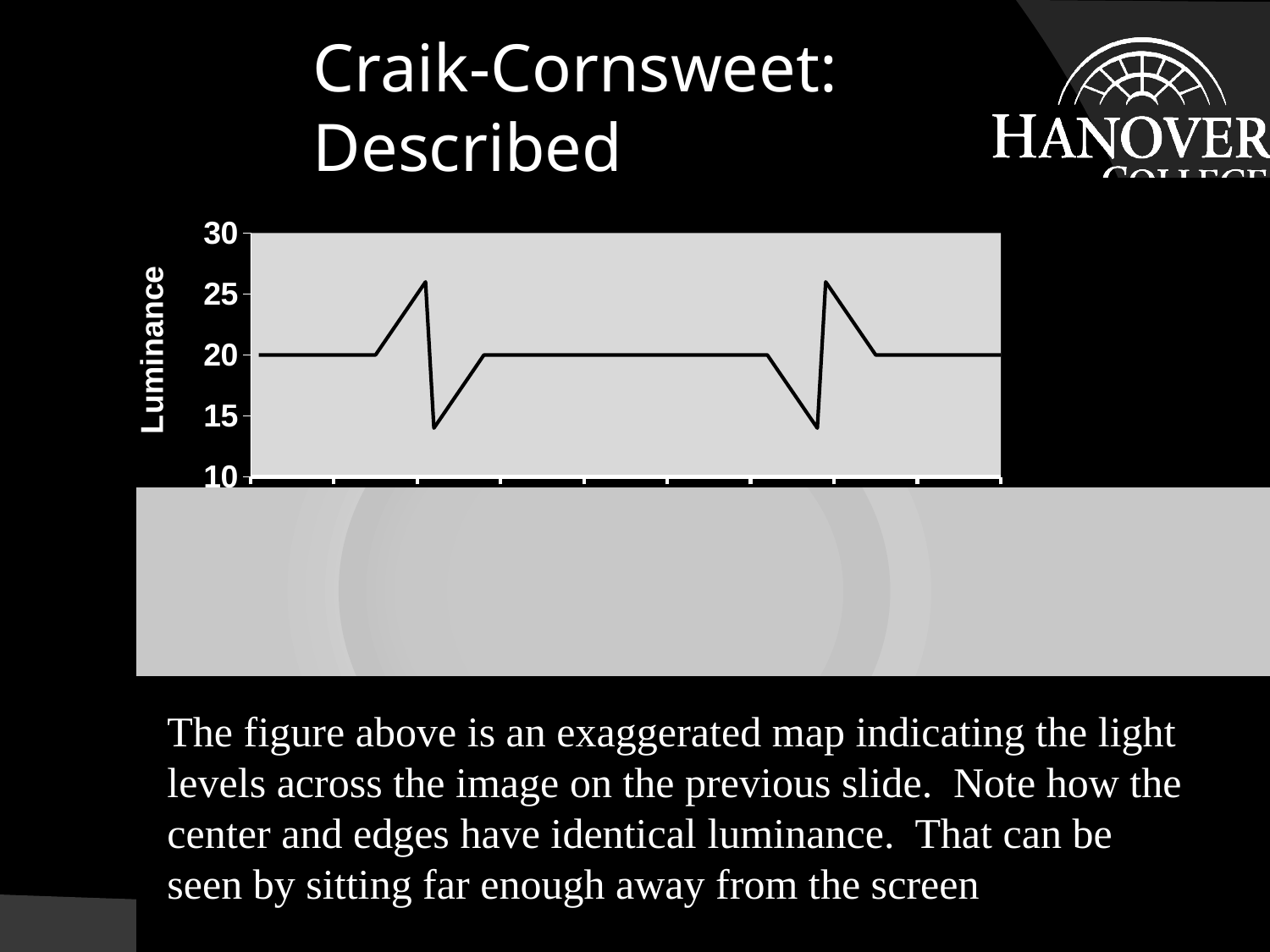
Is the value at the first trough of the line greater or less than 20? less What is the highest value shown on the vertical axis of the chart? 30 What kind of chart is shown on the slide? line chart How many peaks above the flat level does the line have? 2 Is the value at the second peak of the line greater or less than 15? greater Is the value at the first peak of the line greater or less than 20? greater What luminance value does the flat section of the line in the center of the chart sit at? 20 What is the title of the vertical axis of the chart? Luminance What luminance value does the flat section of the line at the far left of the chart sit at? 20 Immediately after the first peak, does the line rise or fall? fall How many troughs below the flat level does the line have? 2 Immediately after the second trough, does the line rise or fall? rise